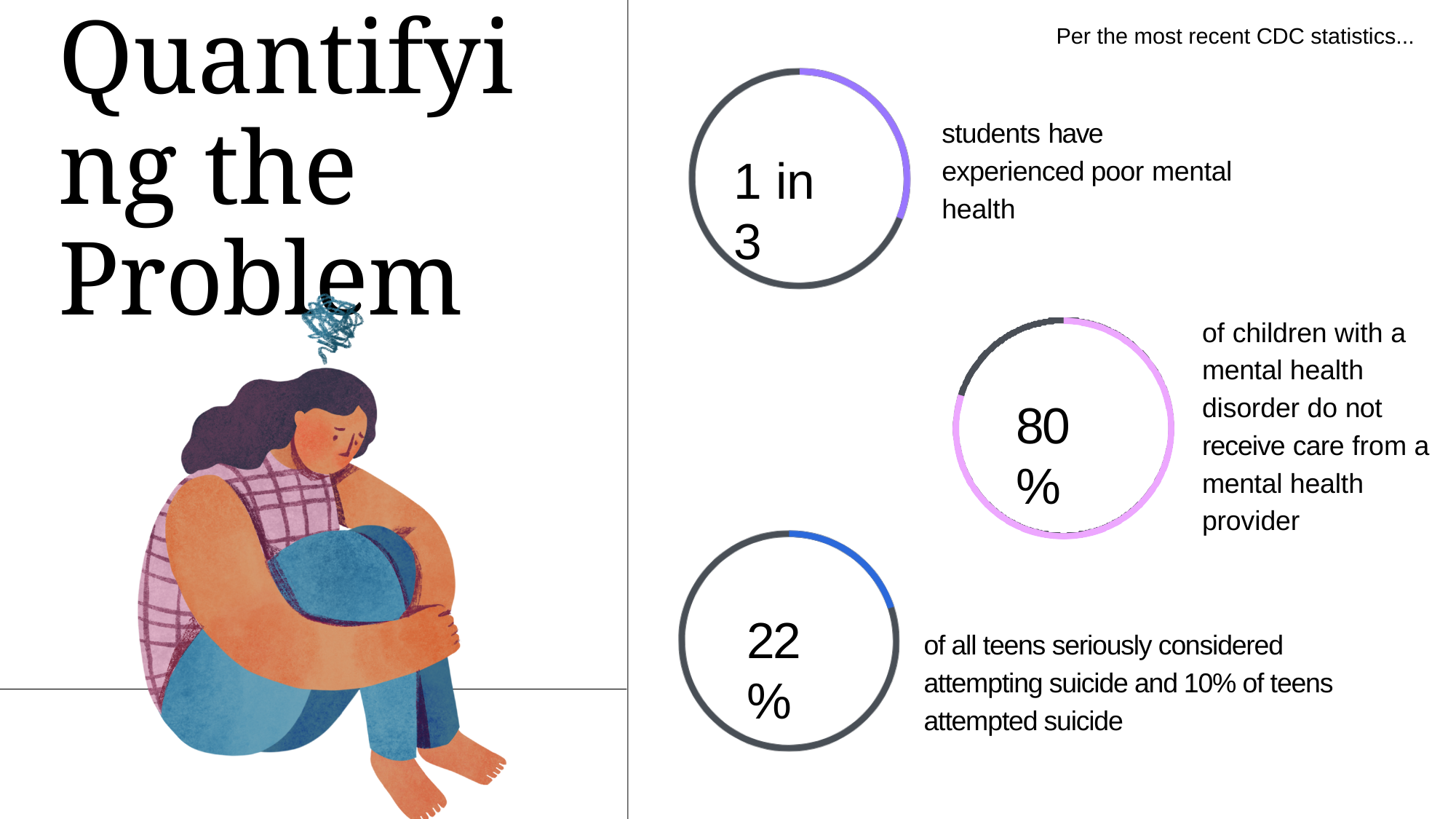
What percentage is shown in the bottom ring chart about teens who seriously considered attempting suicide? 22% What is the difference between the 80% in the middle ring chart and the 22% in the bottom ring chart? 58 percentage points What value is shown in the centre of the top ring chart about students who have experienced poor mental health? 1 in 3 What percentage is shown in the middle ring chart about children with a mental health disorder who do not receive care from a mental health provider? 80% Of the two ring charts showing percentages, which statistic has the highest value? 80% of children with a mental health disorder do not receive care What colour is the filled arc of the middle ring chart showing 80%? Pink Of the two ring charts showing percentages, which statistic has the lowest value? 22% of all teens seriously considered attempting suicide How many ring charts are shown on the slide? 3 According to the text above the ring charts, what is the source of the statistics? Per the most recent CDC statistics... What kind of chart is used to display the statistics on the right side of the slide? Ring (donut) chart Which is larger: the percentage in the middle ring chart (children not receiving care) or the percentage in the bottom ring chart (teens who considered suicide)? 80%